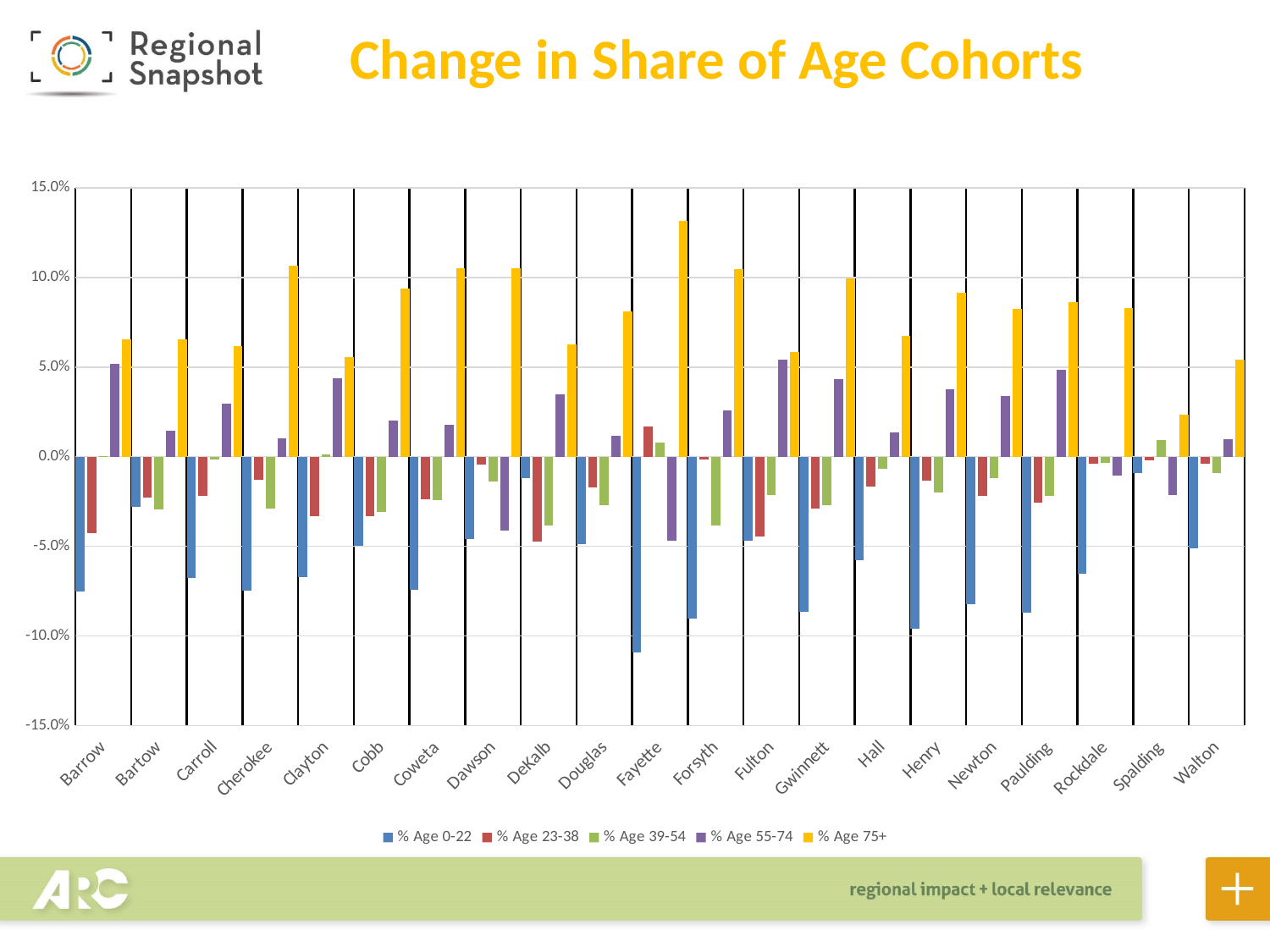
How many counties are shown on the x axis of the chart? 21 Which county has the highest value for % Age 75+? Fayette Is the value for % Age 0-22 in Fayette greater or less than -10.0%? less What kind of chart is shown on the slide? bar chart Is the value for % Age 0-22 in Barrow greater or less than -5.0%? less Which county has the lowest value for % Age 75+? Spalding What is the title of the chart? Change in Share of Age Cohorts Is the value for % Age 75+ in Forsyth greater or less than 10.0%? greater Which county has the lowest value for % Age 0-22? Fayette How many series does the legend list? 5 Which is larger, the % Age 75+ value for Forsyth or for Spalding? Forsyth